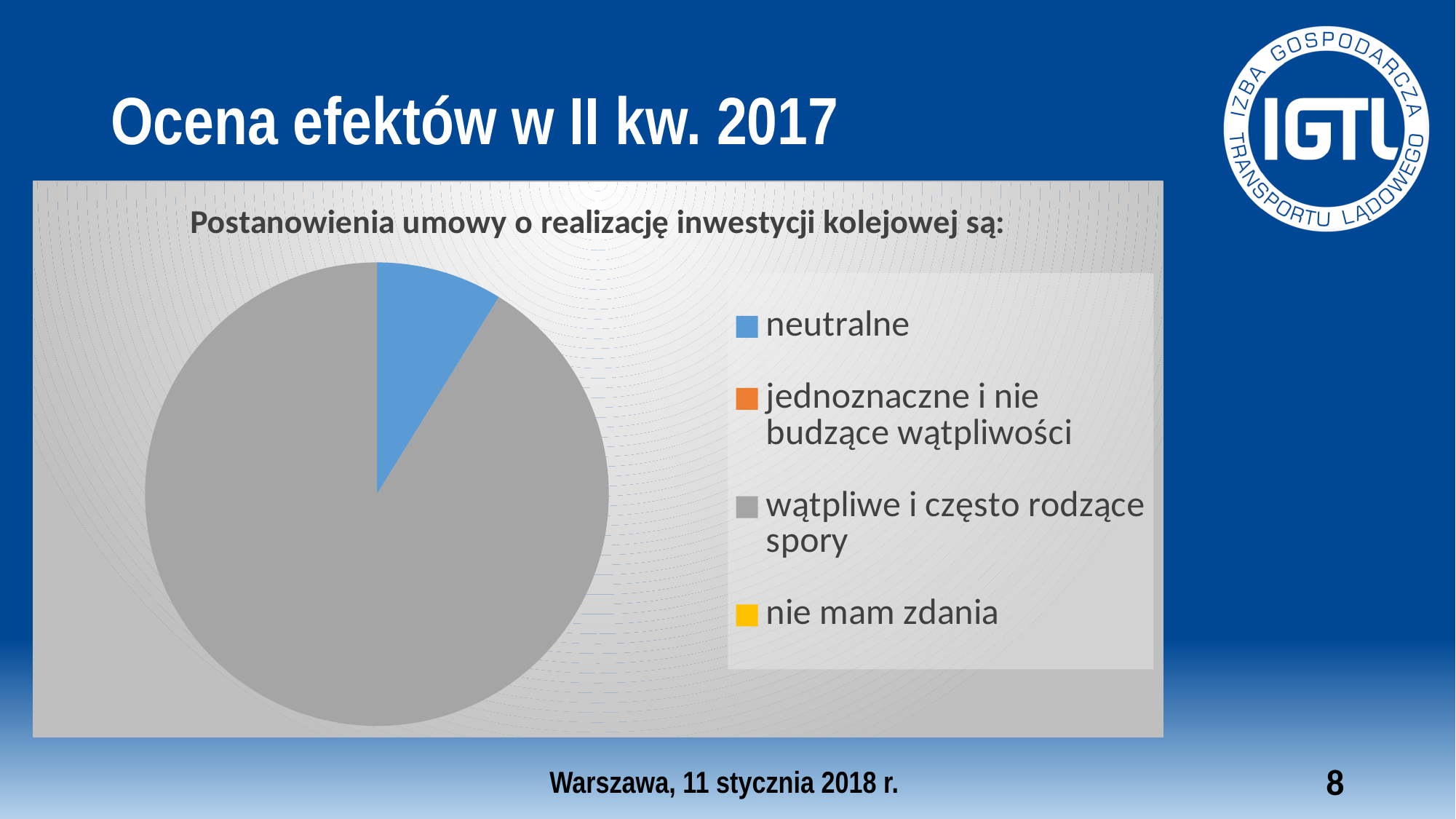
Does the "wątpliwe i często rodzące spory" slice take up more or less than half of the pie? more What kind of chart is shown on the slide? pie chart What is the title of the chart? Postanowienia umowy o realizację inwestycji kolejowej są: Which slice is larger: "neutralne" or "wątpliwe i często rodzące spory"? wątpliwe i często rodzące spory How many slices are visibly drawn in the pie? 2 Which legend category is shown in grey? wątpliwe i często rodzące spory How many entries does the chart's legend list? 4 Which colour represents "neutralne" in the legend? blue Which category has the largest slice of the pie? wątpliwe i często rodzące spory